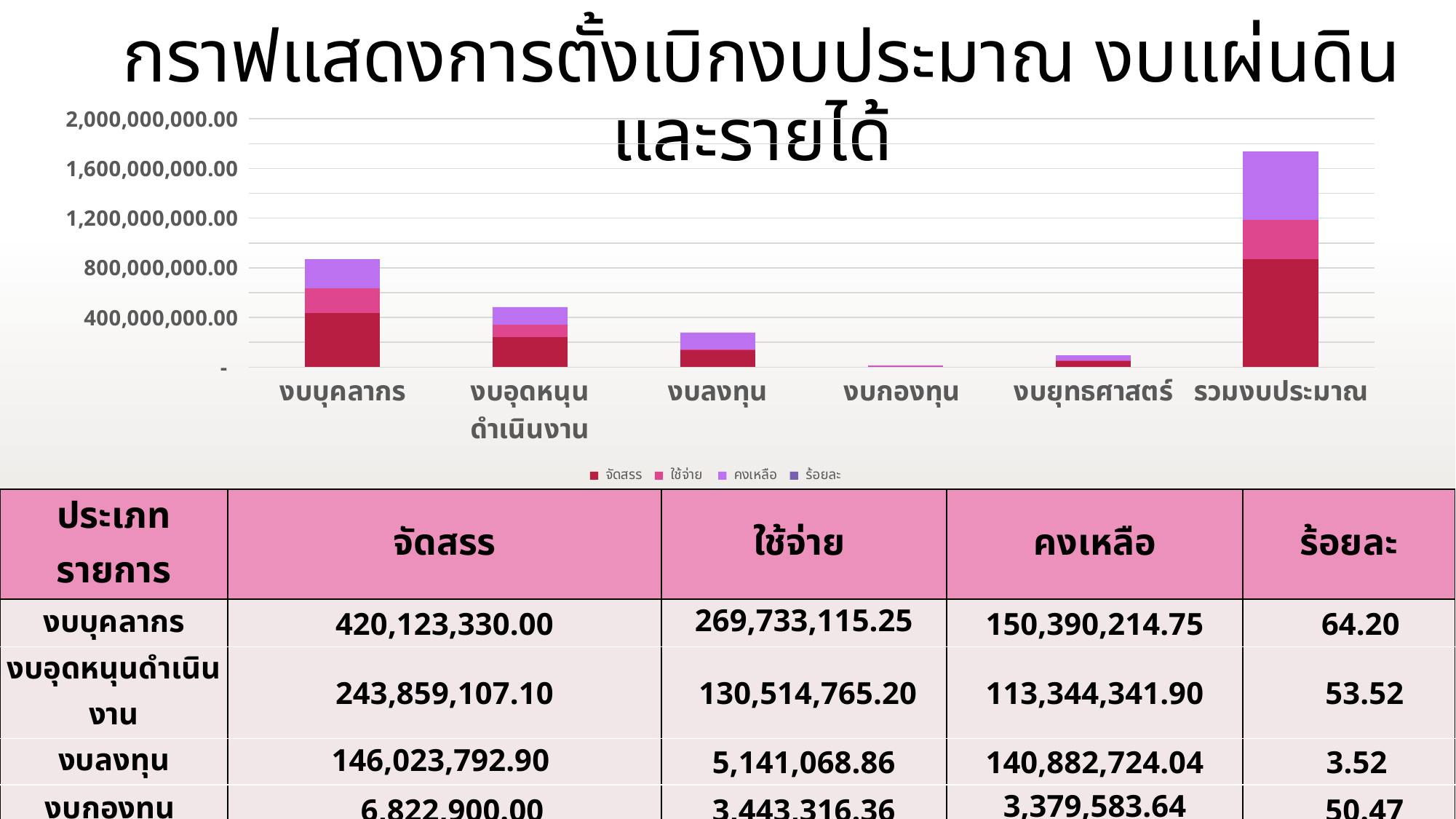
Which category has the shortest stacked bar in the chart? งบกองทุน According to the table on the slide, what is the ใช้จ่าย value for งบลงทุน? 5,141,068.86 According to the table on the slide, what is the จัดสรร value for งบบุคลากร? 420,123,330.00 Is the total height of the งบลงทุน bar greater or less than 400,000,000.00? less Is the total height of the งบอุดหนุนดำเนินงาน bar greater or less than 400,000,000.00? greater Which stacked bar is taller, งบบุคลากร or งบอุดหนุนดำเนินงาน? งบบุคลากร How many categories are shown on the x axis of the chart? 6 How many series does the chart legend list? 4 Which category has the tallest stacked bar in the chart? รวมงบประมาณ What is the first series listed in the chart legend? จัดสรร What kind of chart is shown on the slide? stacked bar chart Is the total height of the รวมงบประมาณ bar greater or less than 1,600,000,000.00? greater